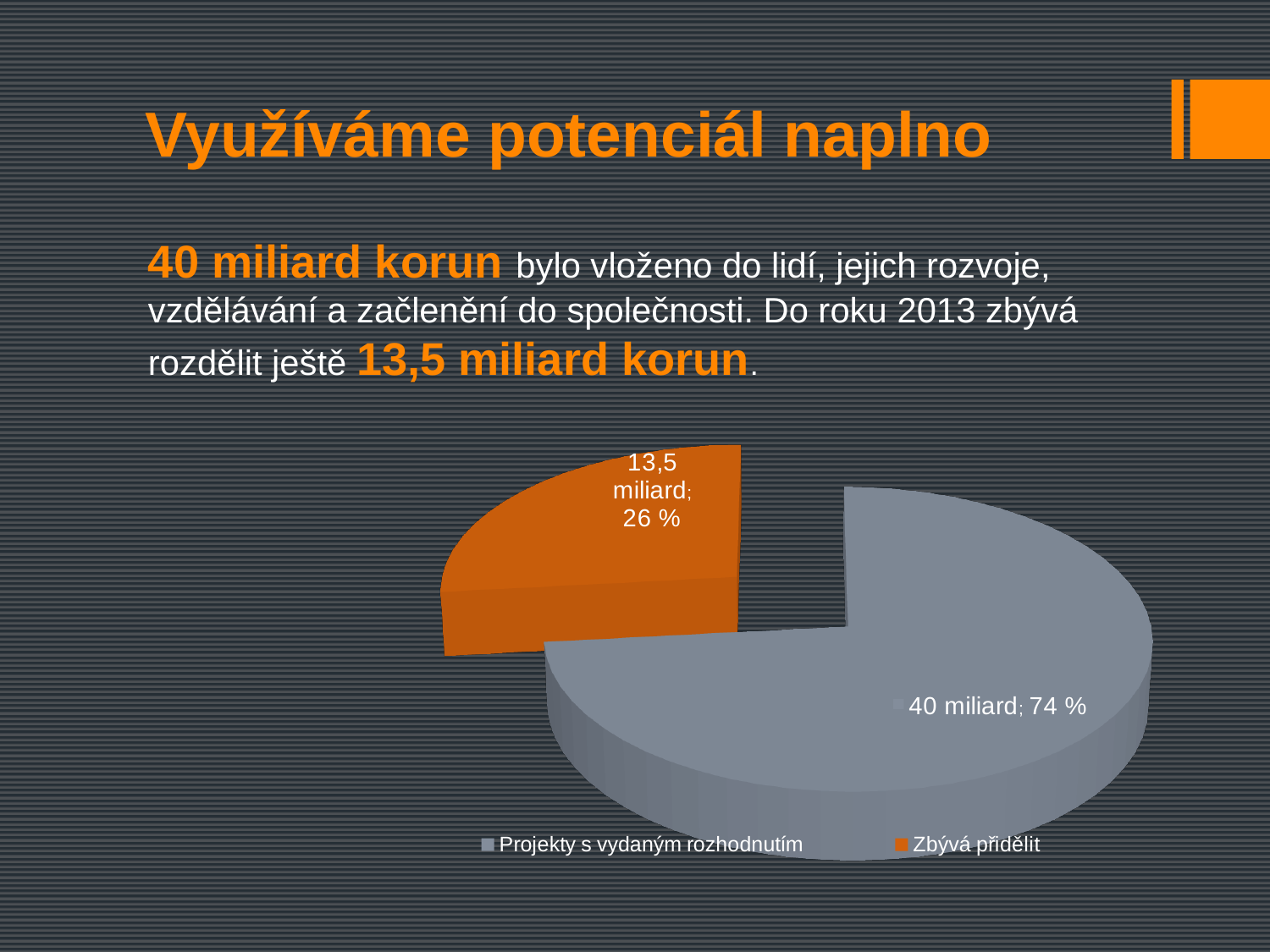
Which is larger: the slice "Projekty s vydaným rozhodnutím" or the slice "Zbývá přidělit"? Projekty s vydaným rozhodnutím What is the difference in percentage points between the two slices of the pie chart? 48 % What value is shown for the slice "Zbývá přidělit"? 13,5 miliard Which slice of the pie chart is the largest? Projekty s vydaným rozhodnutím How many slices does the pie chart have? 2 What share of the pie does the slice "Zbývá přidělit" represent? 26 % What share of the pie does the slice "Projekty s vydaným rozhodnutím" represent? 74 % How many entries does the legend of the pie chart list? 2 What kind of chart is shown on the slide? pie chart Which slice of the pie chart is the smallest? Zbývá přidělit What colour is the slice "Zbývá přidělit" in the pie chart? orange What value is shown for the slice "Projekty s vydaným rozhodnutím"? 40 miliard